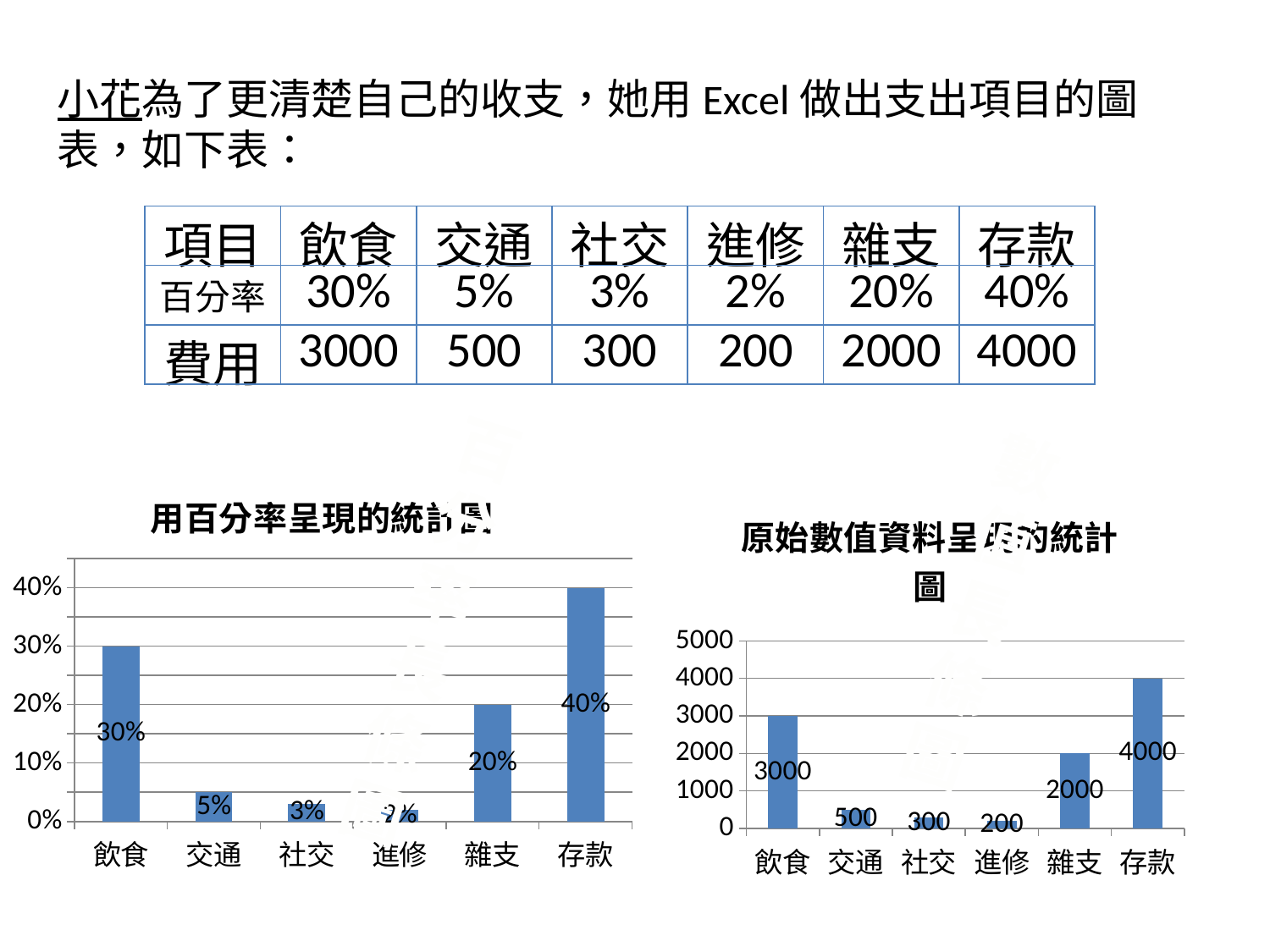
In the right chart (原始數值資料呈現的統計圖), what is the value for 交通? 500 In the left chart (用百分率呈現的統計圖), which category has the lowest value? 進修 In the right chart (原始數值資料呈現的統計圖), is the value for 存款 greater or less than 3000? greater In the right chart (原始數值資料呈現的統計圖), which is larger, the value for 飲食 or the value for 雜支? 飲食 How many categories are shown on the x axis of the left chart (用百分率呈現的統計圖)? 6 What kind of chart is the right chart (原始數值資料呈現的統計圖)? bar chart In the right chart (原始數值資料呈現的統計圖), what is the difference between the values for 飲食 and 雜支? 1000 In the left chart (用百分率呈現的統計圖), what is the value for 飲食? 30% In the right chart (原始數值資料呈現的統計圖), what is the value for 存款? 4000 In the left chart (用百分率呈現的統計圖), what is the value for 雜支? 20% In the left chart (用百分率呈現的統計圖), what is the difference between the values for 存款 and 飲食? 10% In the left chart (用百分率呈現的統計圖), which category has the highest value? 存款